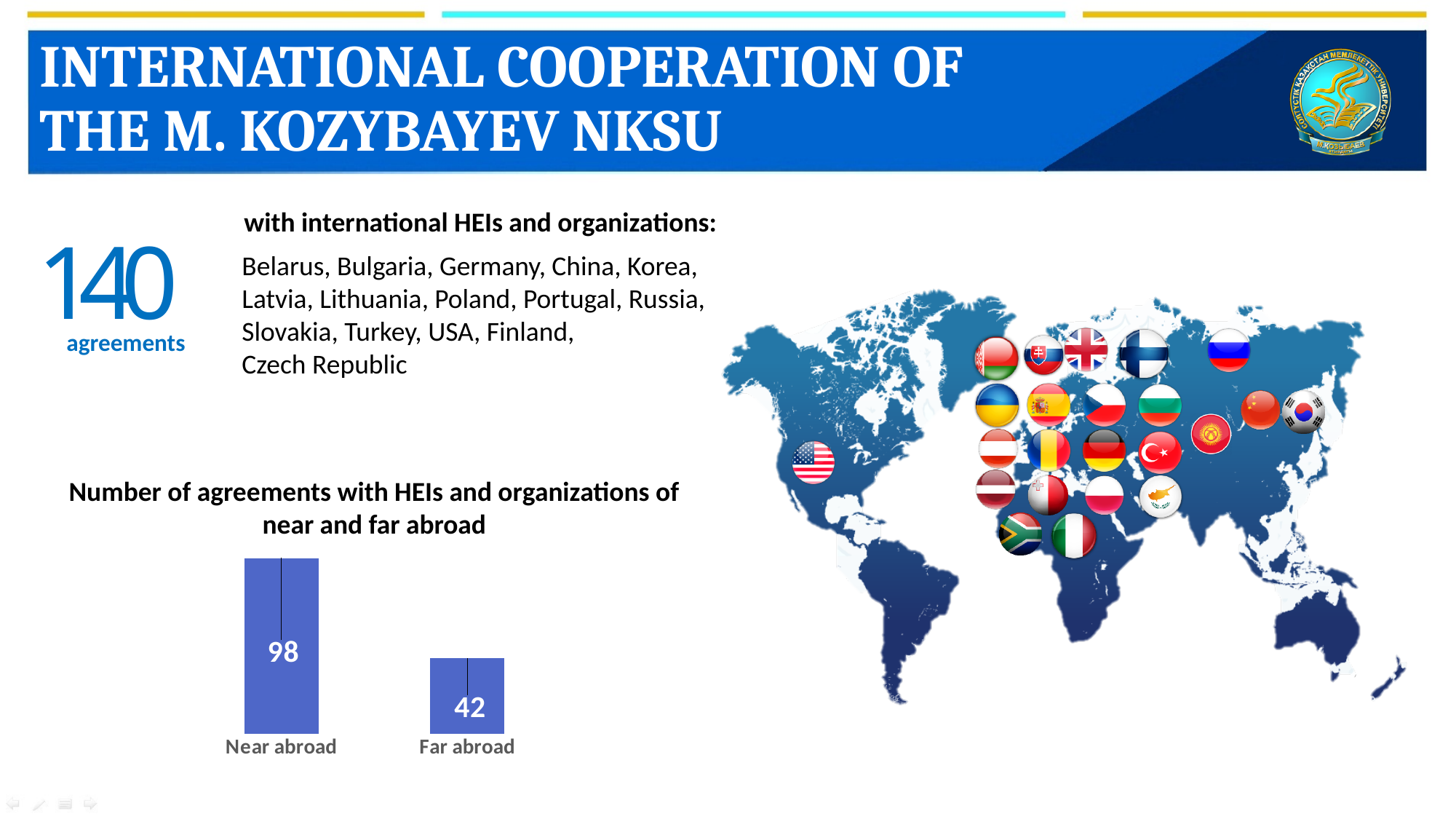
Which category has the higher number of agreements? Near abroad Do the values rise or fall from Near abroad to Far abroad? fall Which category has the lower number of agreements? Far abroad What is the difference between the Near abroad and Far abroad values? 56 How many categories are shown in the chart? 2 What kind of chart is shown on the slide? bar chart What is the total of the Near abroad and Far abroad values? 140 What is the number of agreements for Near abroad? 98 Is the value for Near abroad larger or smaller than the value for Far abroad? larger What is the title of the chart? Number of agreements with HEIs and organizations of near and far abroad What is the number of agreements for Far abroad? 42